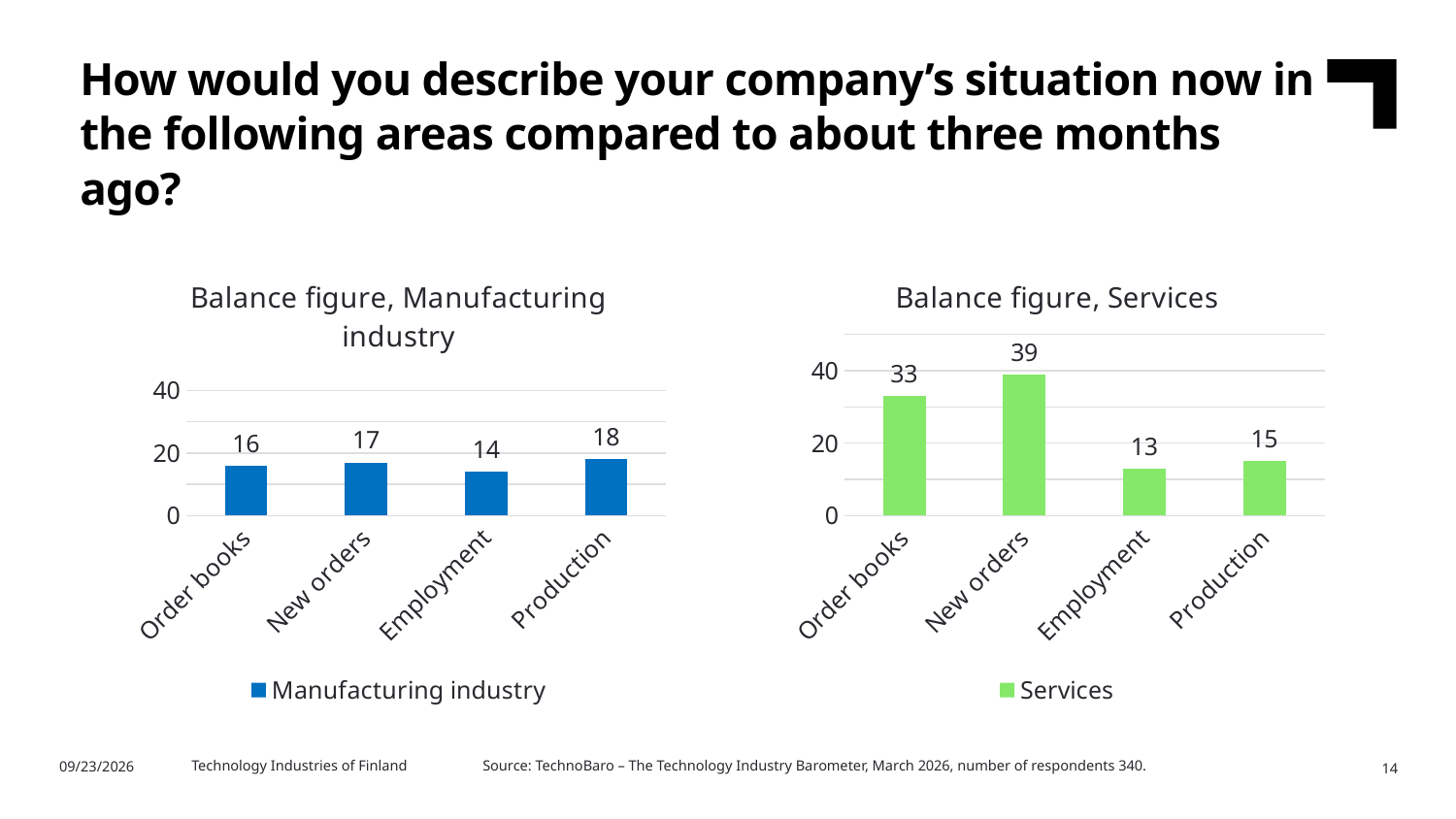
How many categories are shown in the 'Balance figure, Services' chart? 4 In the 'Balance figure, Manufacturing industry' chart, which category has the lowest value? Employment Which is larger: the value for Order books in the Services chart or the value for Order books in the Manufacturing industry chart? Services In the 'Balance figure, Services' chart, what is the value for Employment? 13 In the 'Balance figure, Manufacturing industry' chart, what is the difference between the values for Production and Employment? 4 What kind of chart is the 'Balance figure, Manufacturing industry' chart? Bar chart In the 'Balance figure, Services' chart, what is the value for New orders? 39 In the 'Balance figure, Services' chart, which category has the highest value? New orders What series does the legend of the 'Balance figure, Services' chart list? Services In the 'Balance figure, Manufacturing industry' chart, which category has the highest value? Production In the 'Balance figure, Manufacturing industry' chart, what is the value for Order books? 16 In the 'Balance figure, Services' chart, what is the difference between the values for New orders and Employment? 26